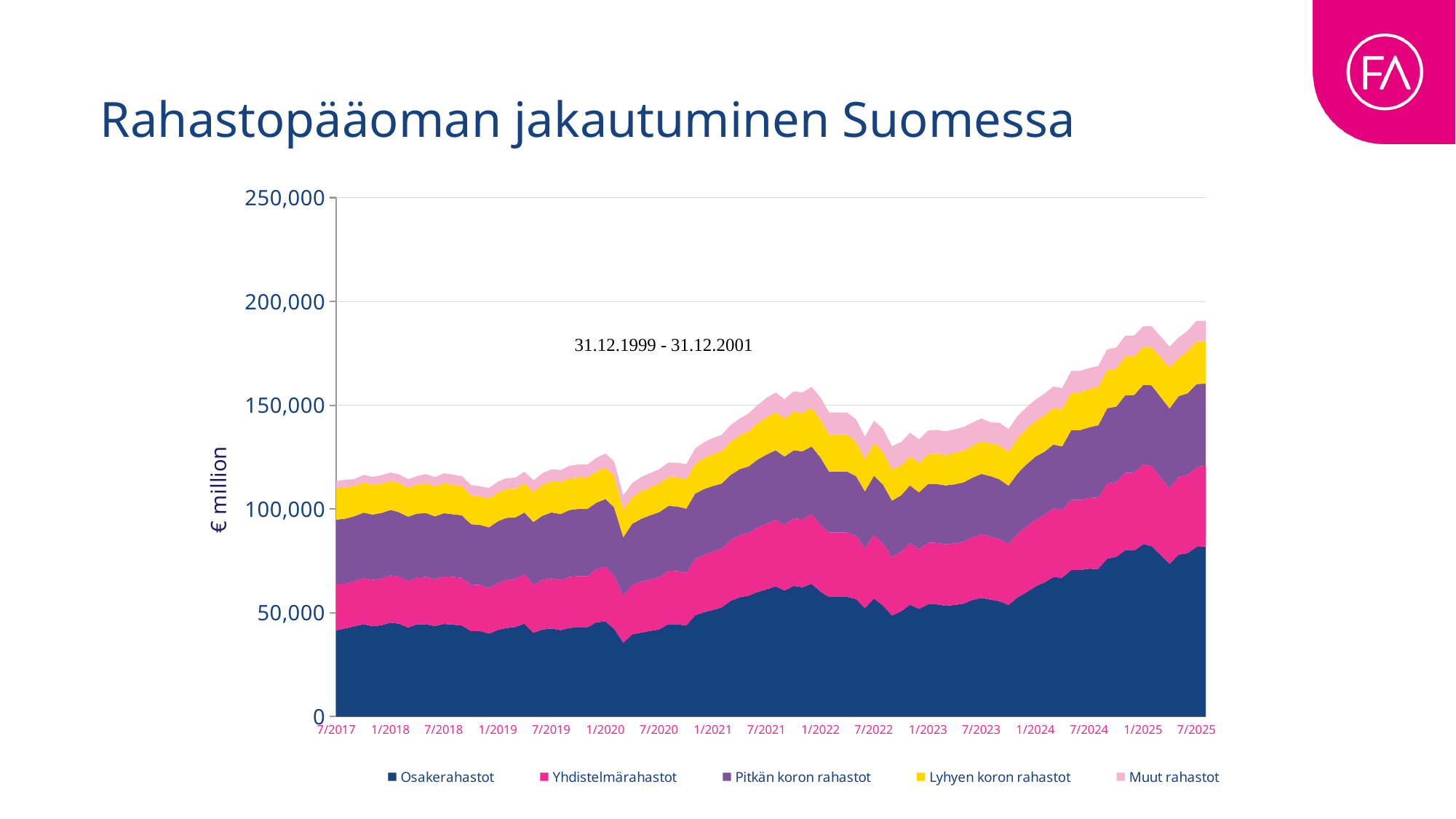
How many series does the legend list? 5 Is the total fund capital at 7/2025 greater or less than 150,000? greater Is the total fund capital at 7/2017 greater or less than 150,000? less Is the value for Osakerahastot at 7/2017 greater or less than 50,000? less Which series has the smallest value at 7/2025? Muut rahastot What kind of chart is shown on the slide? Stacked area chart Which series has the largest value at 7/2025? Osakerahastot How many date labels are shown on the x axis? 17 What unit is shown on the vertical axis label? € million What is the title of the chart? Rahastopääoman jakautuminen Suomessa Does the total fund capital rise or fall between 7/2017 and 7/2025? Rise